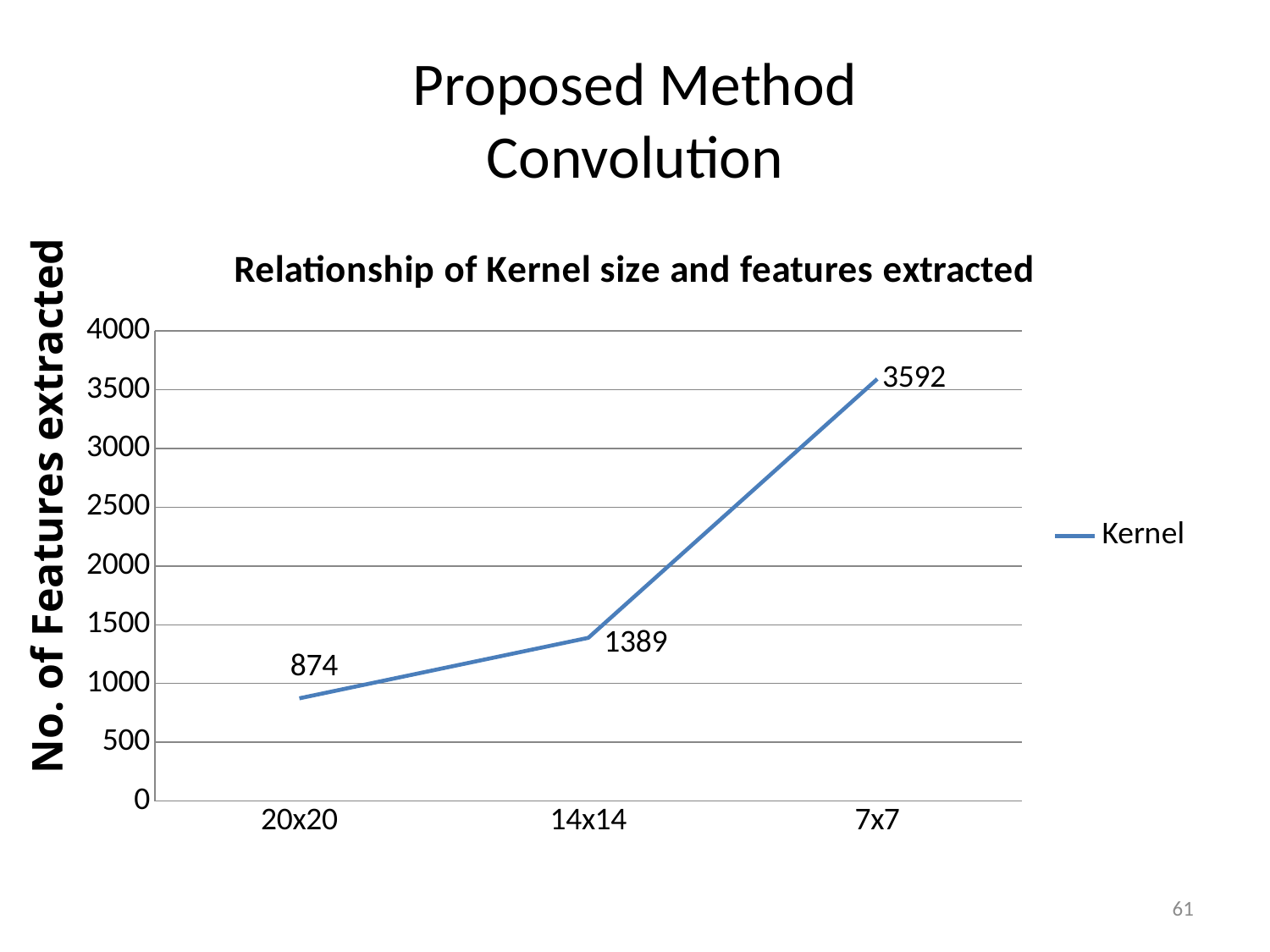
Which kernel size has the highest number of features extracted? 7x7 Which kernel size has more features extracted, 20x20 or 14x14? 14x14 How many kernel sizes are plotted on the x axis? 3 What is the number of features extracted for the 7x7 kernel size? 3592 What is the number of features extracted for the 20x20 kernel size? 874 What kind of chart is shown on the slide? Line chart Do the values rise or fall moving from 20x20 to 7x7 along the x axis? Rise What is the difference in features extracted between the 7x7 and 14x14 kernel sizes? 2203 How many series does the legend list? 1 What is the difference in features extracted between the 14x14 and 20x20 kernel sizes? 515 What is the number of features extracted for the 14x14 kernel size? 1389 Which kernel size has the lowest number of features extracted? 20x20